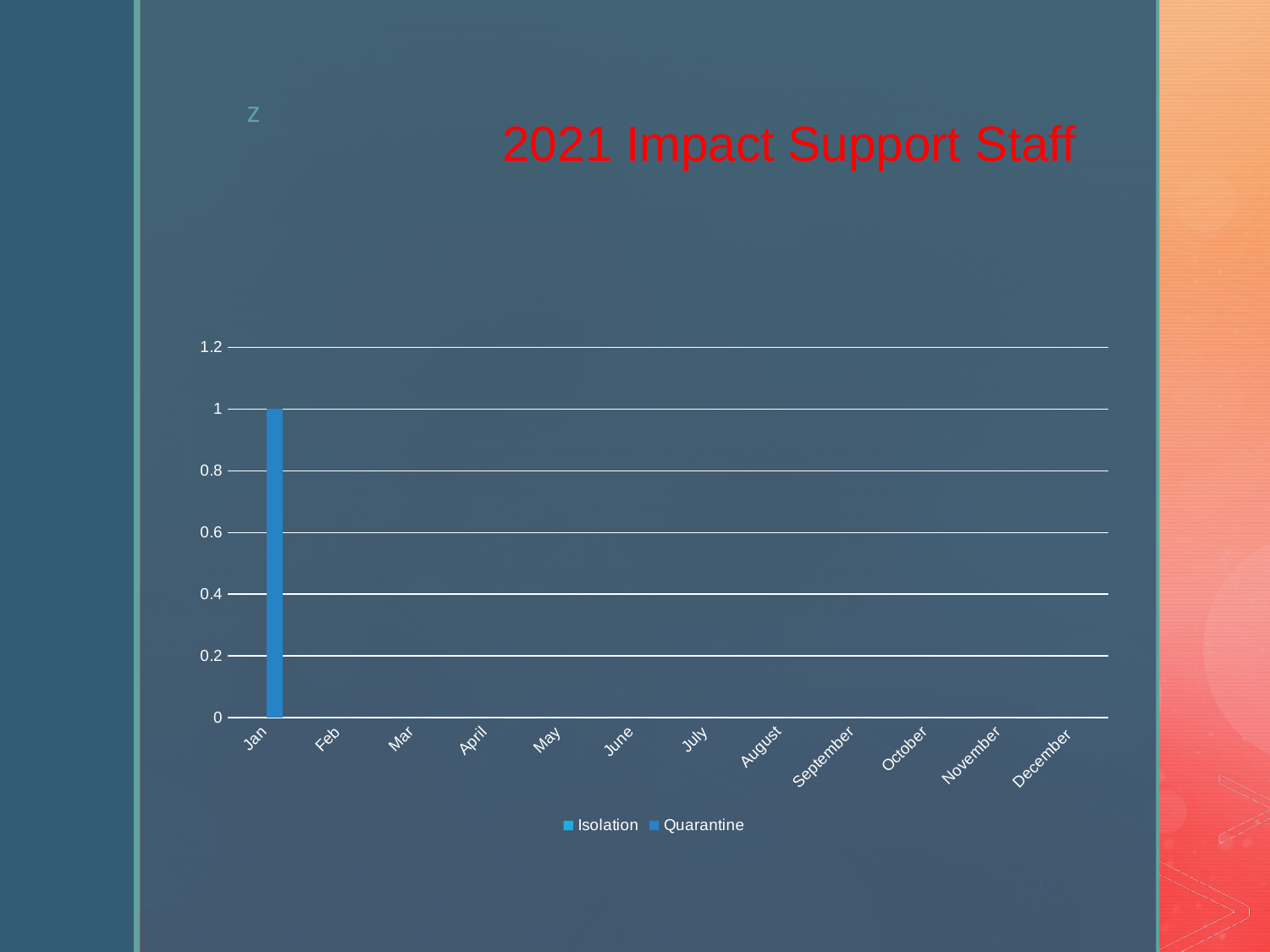
Is the value for Jan greater or less than 1.2? less Which is larger, the value for Jan or the value for Feb? Jan What is the title of the chart? 2021 Impact Support Staff What value does the bar for Jan reach? 1 Is the value for Jan greater or less than 0.8? greater What is the highest value shown on the y axis? 1.2 What are the two series named in the legend? Isolation and Quarantine Which month has the highest bar? Jan Which is the only month with a visible bar? Jan How many series does the legend list? 2 How many month categories are shown on the x axis? 12 What kind of chart is shown on the slide? bar chart